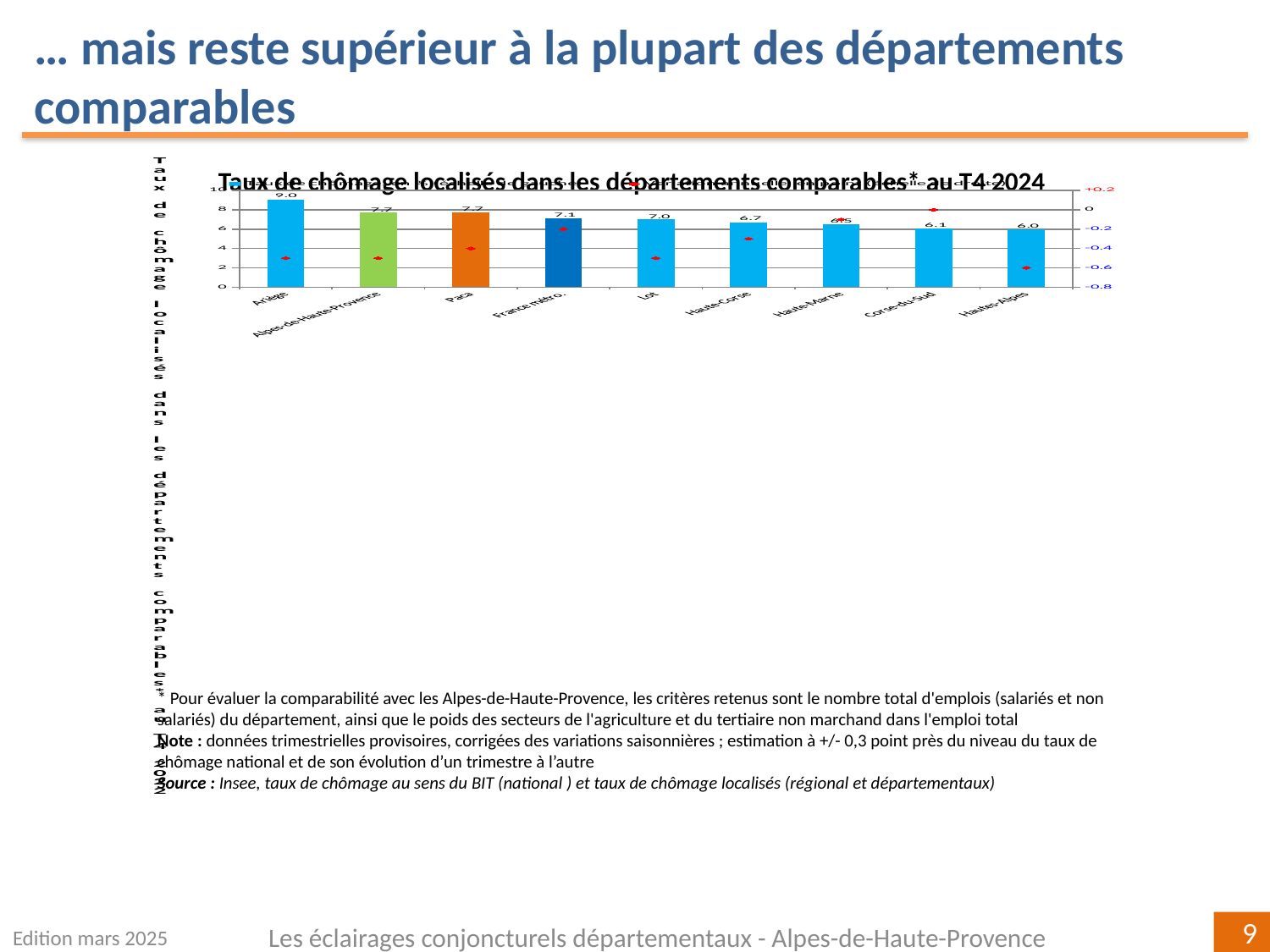
What value is shown for Hautes-Alpes? 6.0 What is the difference between the values for Ariège and Alpes-de-Haute-Provence? 1.3 What is the title of the chart? Taux de chômage localisés dans les départements comparables* au T4 2024 Which category has the lowest value on the chart? Hautes-Alpes What is the unemployment rate shown for Ariège? 9.0 What value is shown for France métro.? 7.1 Do the bar values rise or fall from left to right across the chart? Fall How many categories (bars) are shown on the chart? 9 What kind of chart is used to show the unemployment rates? Bar chart Which department has the highest unemployment rate on the chart? Ariège Which is larger, the value for Lot or the value for Haute-Corse? Lot What value is shown for Alpes-de-Haute-Provence? 7.7